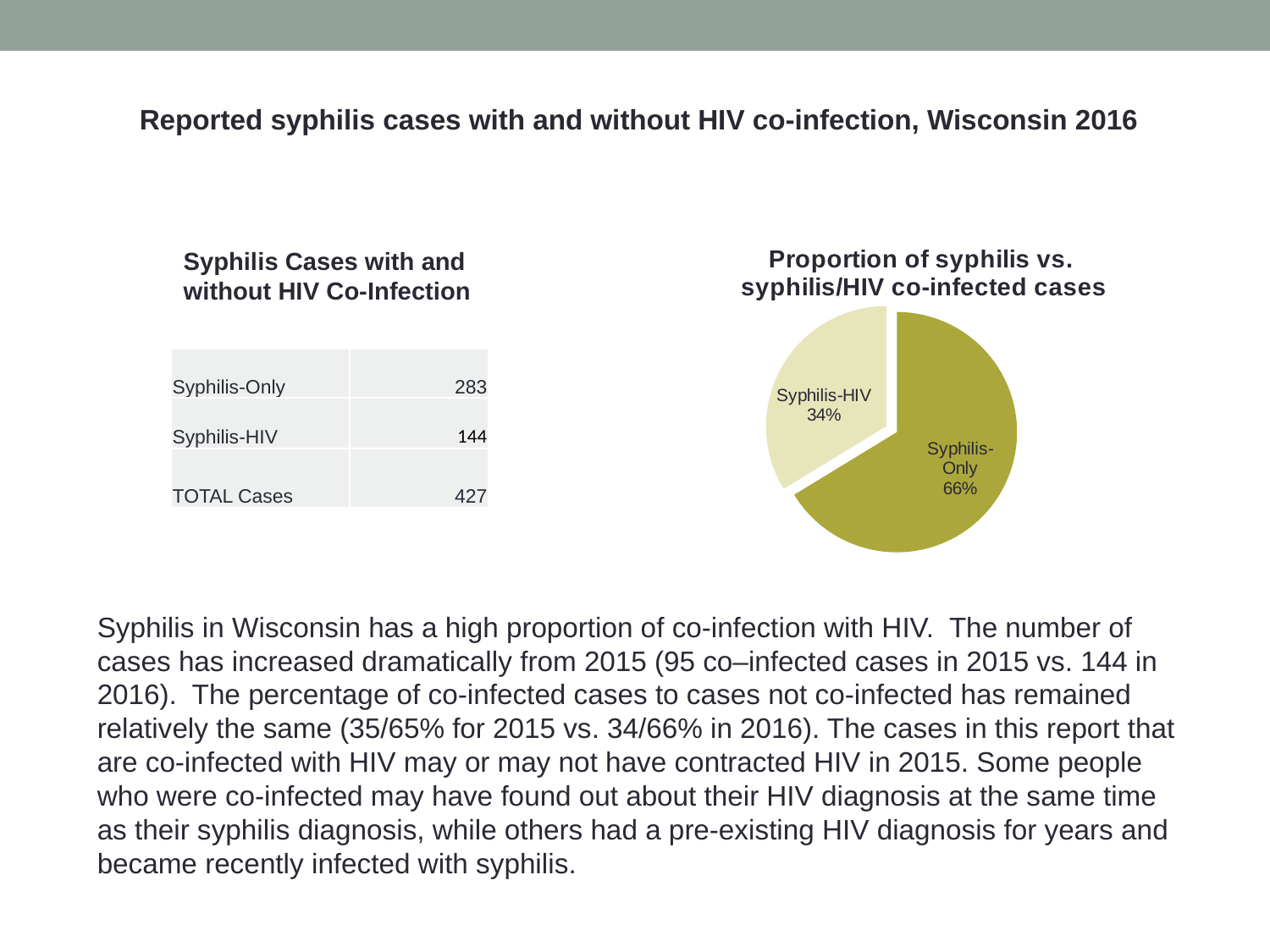
What is the title of the pie chart on the right? Proportion of syphilis vs. syphilis/HIV co-infected cases In the table 'Syphilis Cases with and without HIV Co-Infection', how many Syphilis-HIV cases are listed? 144 In the pie chart, what share of cases is Syphilis-HIV? 34% What kind of chart is the 'Proportion of syphilis vs. syphilis/HIV co-infected cases' chart? pie chart In the table, what is the difference between Syphilis-Only and Syphilis-HIV cases? 139 In the pie chart, what is the difference in percentage points between the Syphilis-Only and Syphilis-HIV slices? 32 In the pie chart, which slice is larger, Syphilis-Only or Syphilis-HIV? Syphilis-Only In the pie chart, what share of cases is Syphilis-Only? 66% How many slices does the pie chart have? 2 In the table 'Syphilis Cases with and without HIV Co-Infection', what is the TOTAL Cases value? 427 In the pie chart, which category has the smallest slice? Syphilis-HIV In the table 'Syphilis Cases with and without HIV Co-Infection', how many Syphilis-Only cases are listed? 283